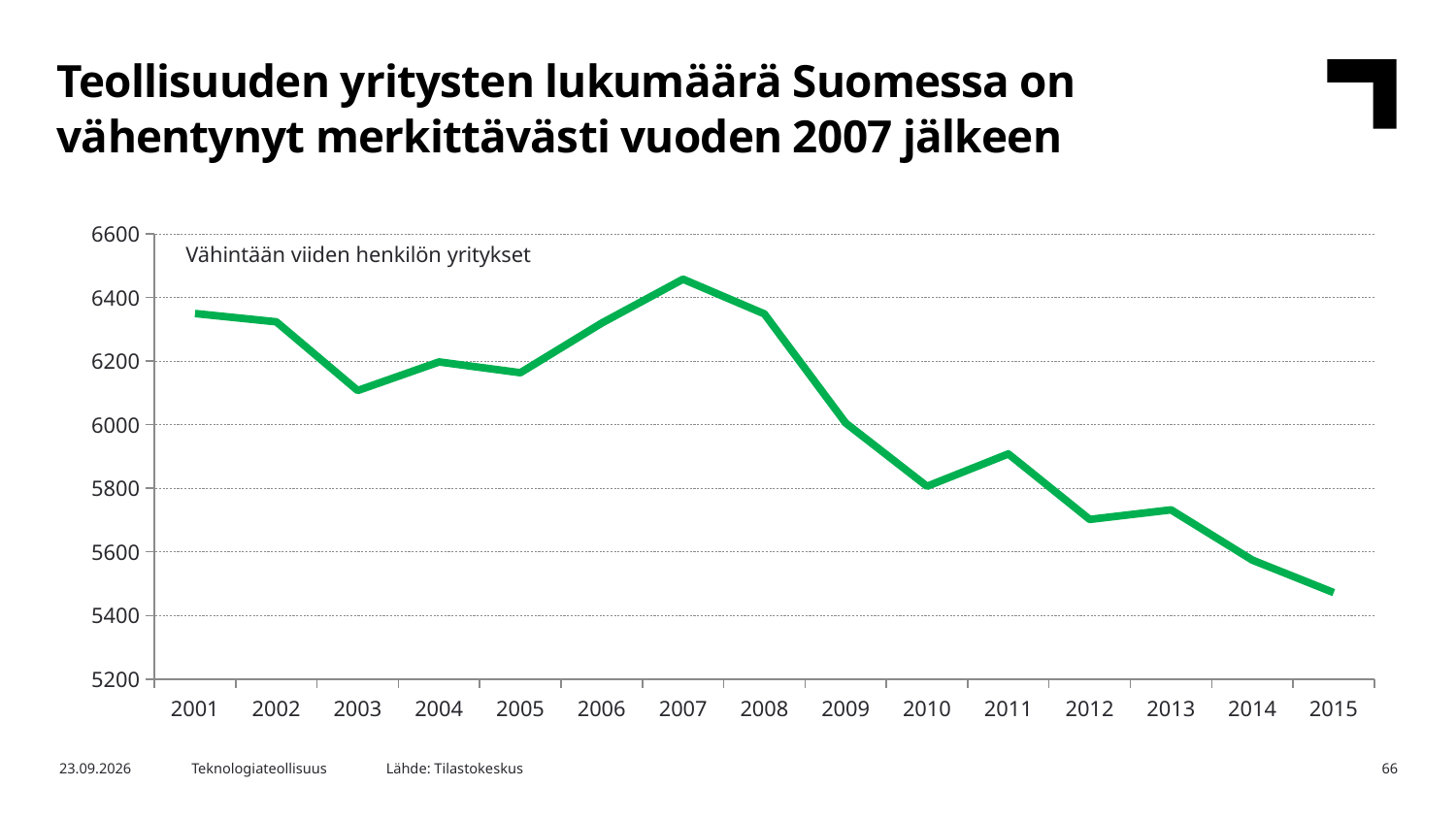
Is the value for 2007 greater or less than 6400? greater What kind of chart is shown on the slide? line chart Is the value for 2003 greater or less than 6200? less What text label is shown inside the chart area above the line? Vähintään viiden henkilön yritykset In which year is the number of companies lowest? 2015 Is the value for 2011 greater or less than 5800? greater Which year has the larger value, 2001 or 2015? 2001 Overall, do the values rise or fall from 2007 to 2015? fall How many years are plotted on the x axis? 15 In which year is the number of companies highest? 2007